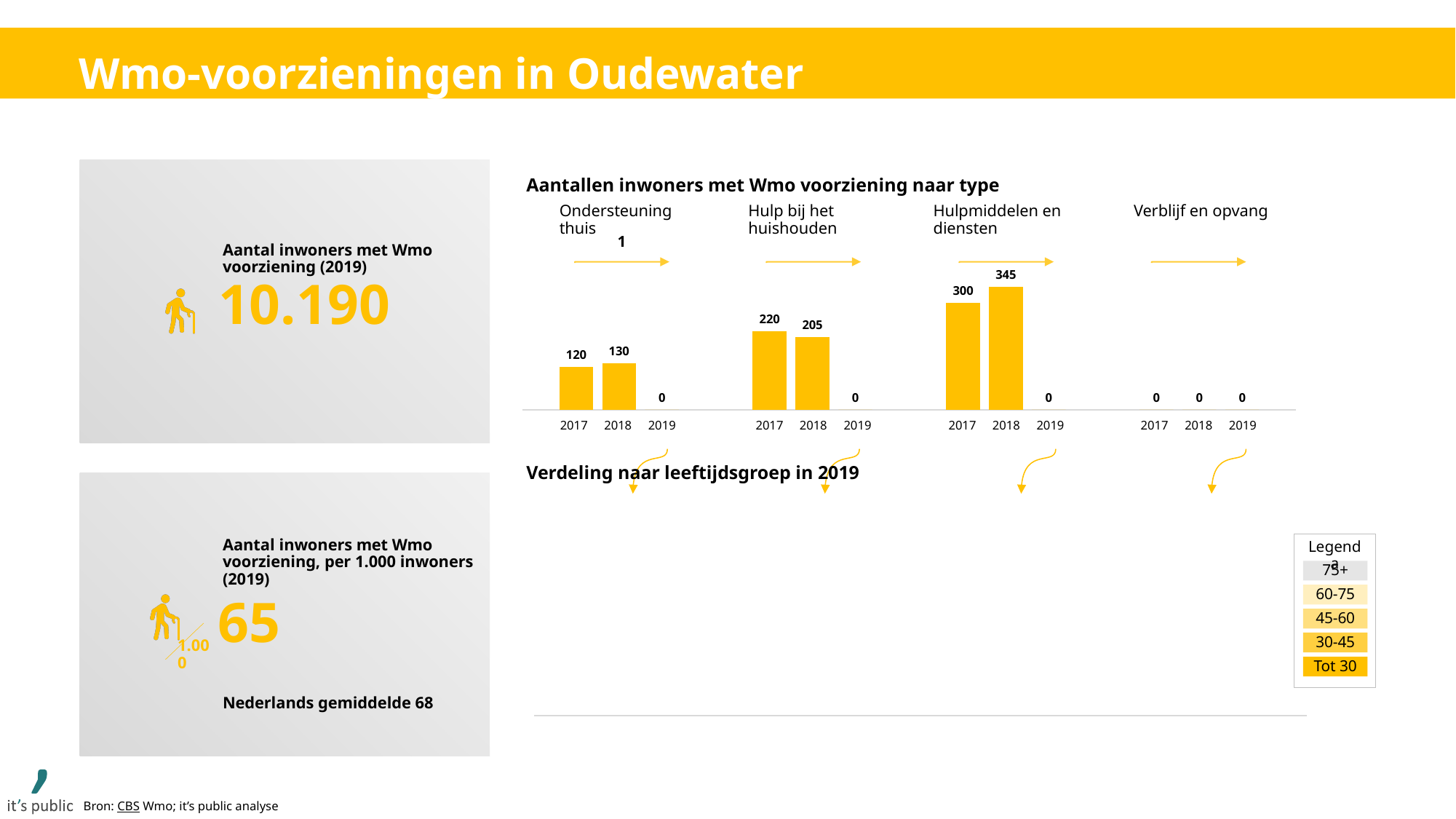
In the chart 'Aantallen inwoners met Wmo voorziening naar type', how many Wmo types are shown? 4 In the chart 'Aantallen inwoners met Wmo voorziening naar type', which is larger: Ondersteuning thuis in 2018 or Hulp bij het huishouden in 2018? Hulp bij het huishouden in 2018 In the chart 'Aantallen inwoners met Wmo voorziening naar type', what is the difference between the 2018 and 2017 values for Hulpmiddelen en diensten? 45 In the chart 'Aantallen inwoners met Wmo voorziening naar type', what is the value for Hulp bij het huishouden in 2018? 205 In the chart 'Aantallen inwoners met Wmo voorziening naar type', what is the value for Hulpmiddelen en diensten in 2018? 345 In the chart 'Aantallen inwoners met Wmo voorziening naar type', what is the value for Ondersteuning thuis in 2017? 120 In the chart 'Aantallen inwoners met Wmo voorziening naar type', does the value for Ondersteuning thuis rise or fall from 2017 to 2018? rise In the chart 'Aantallen inwoners met Wmo voorziening naar type', what is the value for Verblijf en opvang in 2017? 0 How many age groups does the legend next to 'Verdeling naar leeftijdsgroep in 2019' list? 5 What kind of chart is 'Aantallen inwoners met Wmo voorziening naar type'? bar chart In the chart 'Aantallen inwoners met Wmo voorziening naar type', what is the difference between the 2017 and 2018 values for Hulp bij het huishouden? 15 In the chart 'Aantallen inwoners met Wmo voorziening naar type', which type has the highest value in 2018? Hulpmiddelen en diensten